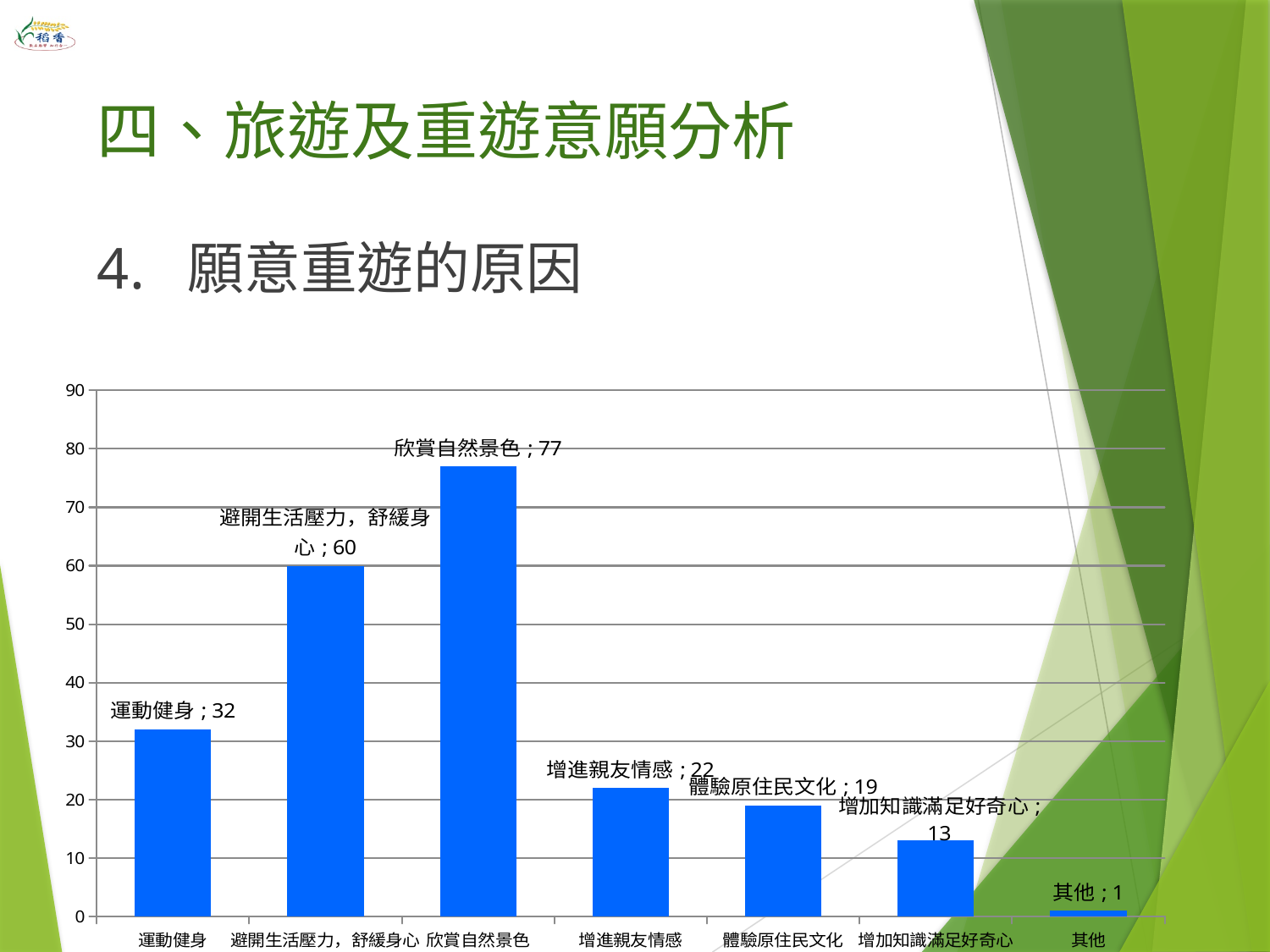
What is the value for 運動健身? 32 What colour are the bars in the chart? blue What is the value for 增加知識滿足好奇心? 13 Is the value for 避開生活壓力，舒緩身心 greater or less than 50? greater What kind of chart is shown on the slide? bar chart How many categories are shown on the x axis? 7 Which is larger, the value for 增進親友情感 or the value for 體驗原住民文化? 增進親友情感 What is the value for 欣賞自然景色? 77 Which category has the lowest value? 其他 What is the difference between the values for 體驗原住民文化 and 其他? 18 Which category has the highest value? 欣賞自然景色 What is the difference between the values for 欣賞自然景色 and 避開生活壓力，舒緩身心? 17